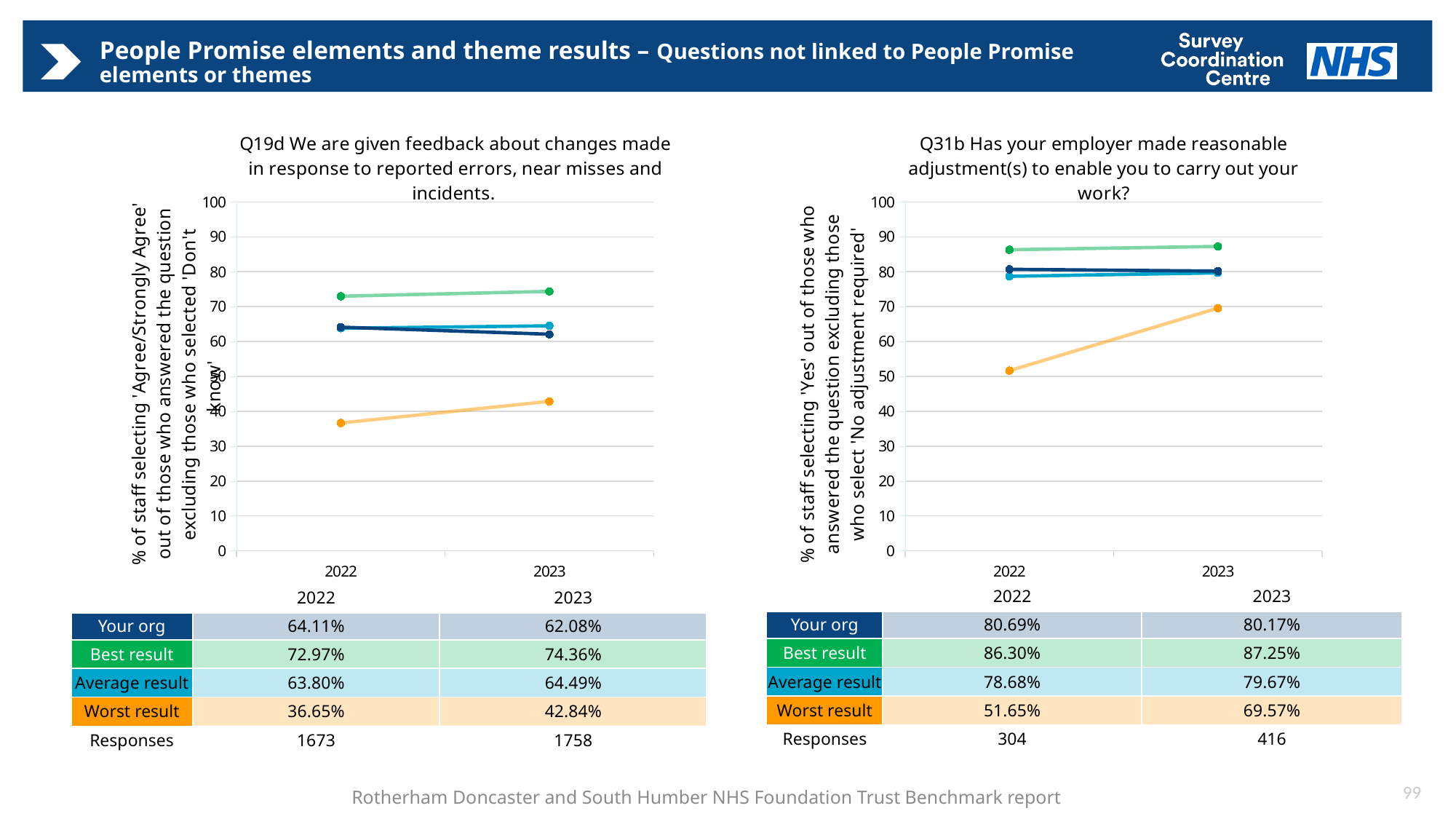
On the Q31b chart, which series has the lowest value in 2022? Worst result On the Q19d chart, does the Your org line rise or fall from 2022 to 2023? fall On the Q19d chart, is the Your org value in 2022 or the Average result value in 2023 larger? Average result in 2023 On the Q19d chart, which series has the highest value in 2023? Best result On the Q31b chart, what is the Average result value in 2022? 78.68% On the Q31b chart, does the Worst result line rise or fall from 2022 to 2023? rise How many years are shown on the x axis of the Q19d chart? 2 On the Q19d chart, what is the Worst result value in 2022? 36.65% On the Q31b chart, what is the difference between the Worst result values in 2023 and 2022? 17.92% On the Q19d chart, what is the value for Your org in 2023? 62.08% What kind of chart is the Q31b chart? line chart On the Q31b chart, what is the Best result value in 2023? 87.25%